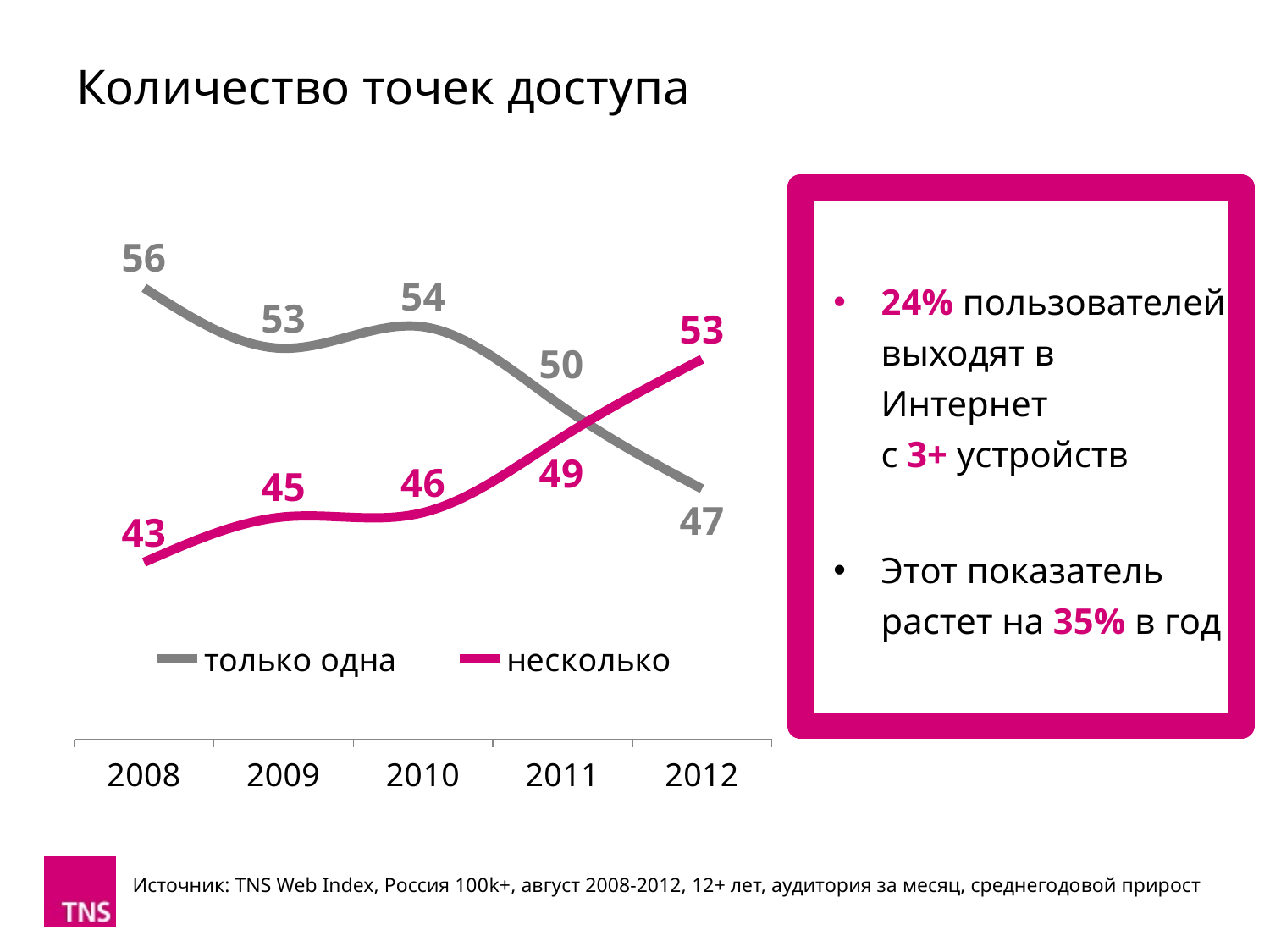
What is the value for 'несколько' in 2010? 46 In which year is the 'только одна' series highest? 2008 What is the value for 'только одна' in 2011? 50 Does the 'несколько' series rise or fall from 2008 to 2012? rise How many series does the legend list? 2 What is the value for 'несколько' in 2012? 53 What kind of chart is shown on the slide? line chart How many years are shown on the x axis? 5 What is the difference between 'только одна' and 'несколько' in 2008? 13 In which year is the 'несколько' series lowest? 2008 What is the value for 'только одна' in 2008? 56 Which series has the larger value in 2012, 'только одна' or 'несколько'? несколько